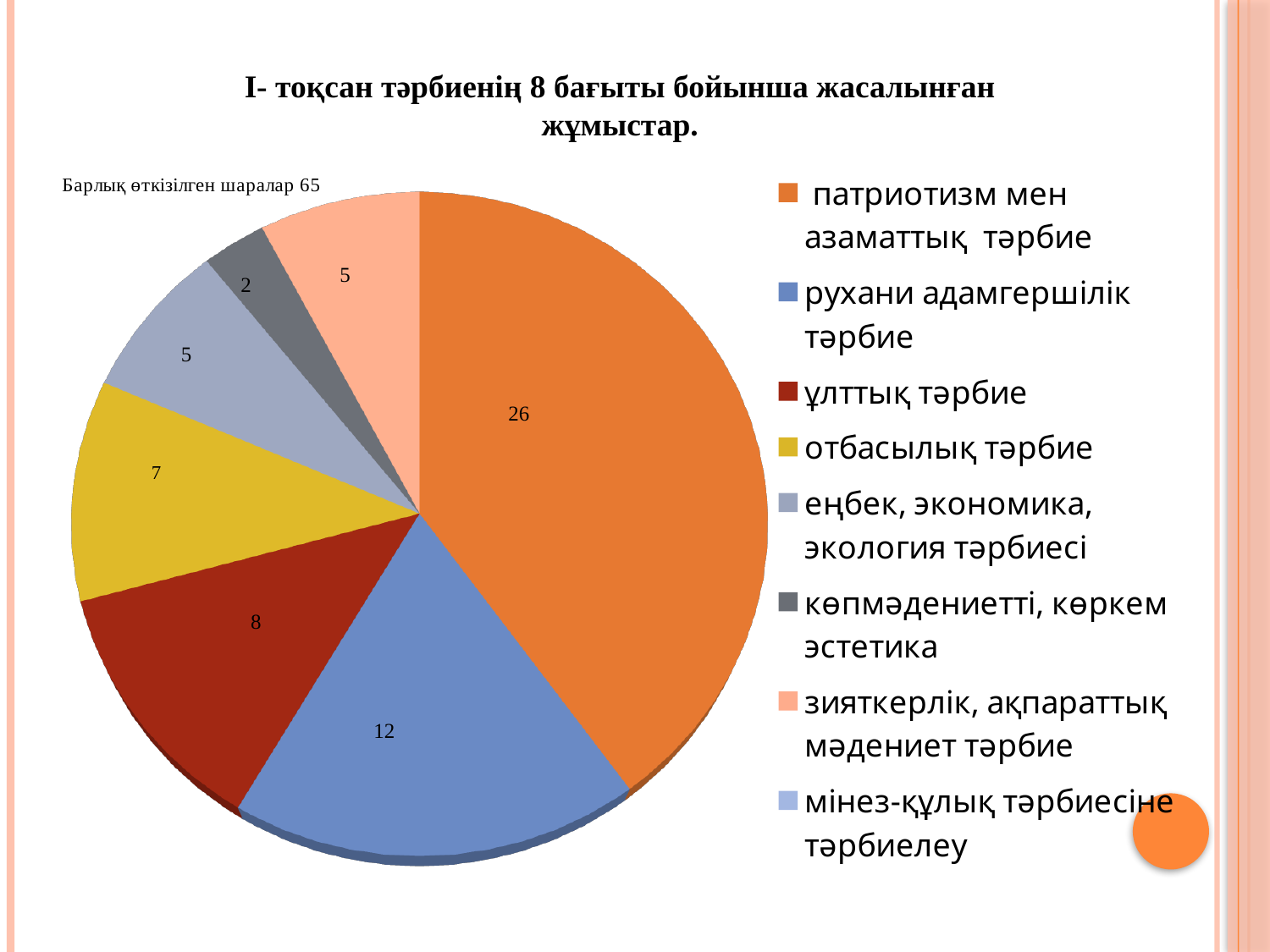
What is the value of the slice for отбасылық тәрбие? 7 Which is larger, the slice for ұлттық тәрбие or the slice for отбасылық тәрбие? ұлттық тәрбие How many entries does the legend of the pie chart list? 8 What is the value of the slice for рухани адамгершілік тәрбие? 12 What is the value of the slice for патриотизм мен азаматтық тәрбие? 26 What is the value of the slice for ұлттық тәрбие? 8 Which labeled slice has the smallest value in the pie chart? көпмәдениетті, көркем эстетика Which category has the largest slice in the pie chart? патриотизм мен азаматтық тәрбие What is the difference between the values for патриотизм мен азаматтық тәрбие and рухани адамгершілік тәрбие? 14 What total number of events (Барлық өткізілген шаралар) is stated above the pie chart? 65 What kind of chart is shown on the slide? pie chart What is the value of the slice for көпмәдениетті, көркем эстетика? 2